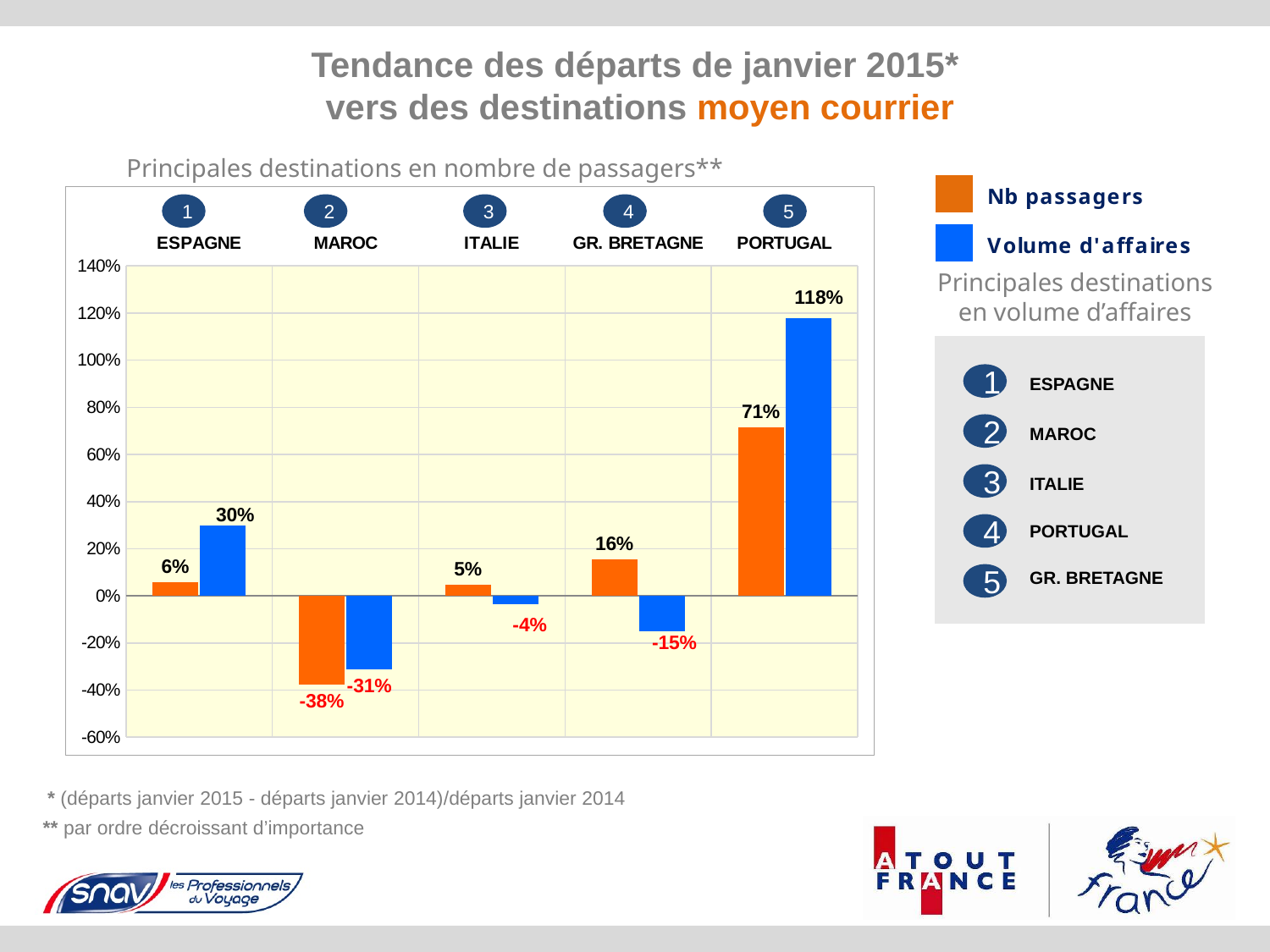
What is the Nb passagers value for PORTUGAL? 71% What kind of chart is shown? bar chart Is the Volume d'affaires value for PORTUGAL greater or less than 100%? greater How many destinations are shown on the chart? 5 Which destination has the highest Volume d'affaires value? PORTUGAL What is the Volume d'affaires value for GR. BRETAGNE? -15% What colour represents Nb passagers in the legend? orange How many series does the legend list? 2 What is the Volume d'affaires value for MAROC? -31% What is the difference between the Volume d'affaires and Nb passagers values for PORTUGAL? 47% Which destination has the lowest Nb passagers value? MAROC Which is larger for ESPAGNE: Nb passagers or Volume d'affaires? Volume d'affaires